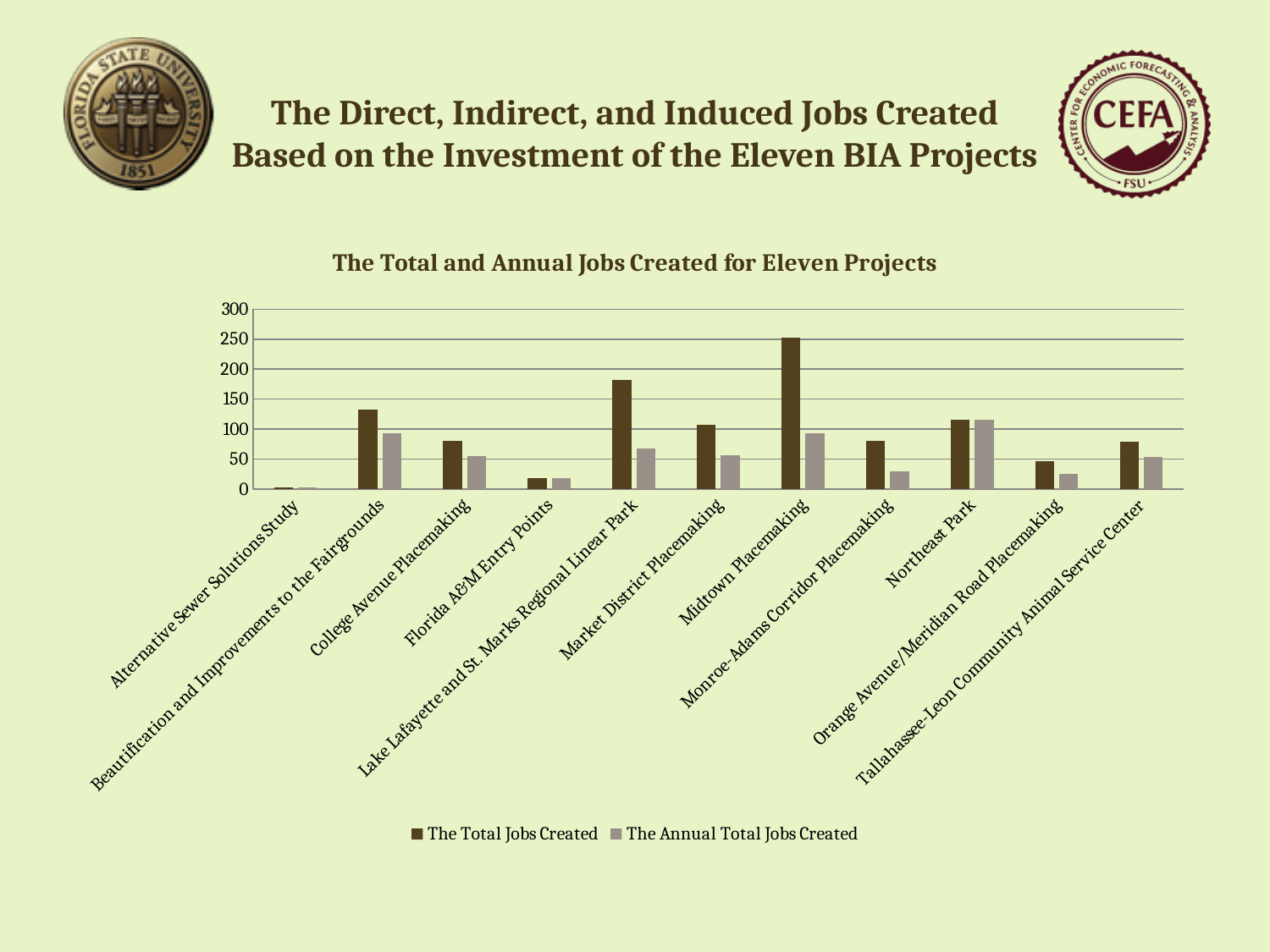
Is the value of The Total Jobs Created for Florida A&M Entry Points greater or less than 50? less Is the value of The Total Jobs Created for Midtown Placemaking greater or less than 200? greater How many series does the chart's legend list? 2 Which project has the highest value for The Total Jobs Created? Midtown Placemaking What kind of chart is shown on the slide? bar chart Is the value of The Total Jobs Created for Lake Lafayette and St. Marks Regional Linear Park greater or less than 150? greater Which is larger: The Total Jobs Created for Lake Lafayette and St. Marks Regional Linear Park or for Market District Placemaking? Lake Lafayette and St. Marks Regional Linear Park Which project has the highest value for The Annual Total Jobs Created? Northeast Park Which project has the lowest value for The Total Jobs Created? Alternative Sewer Solutions Study How many projects (categories) are shown on the x axis of the chart? 11 What is the title of the chart? The Total and Annual Jobs Created for Eleven Projects